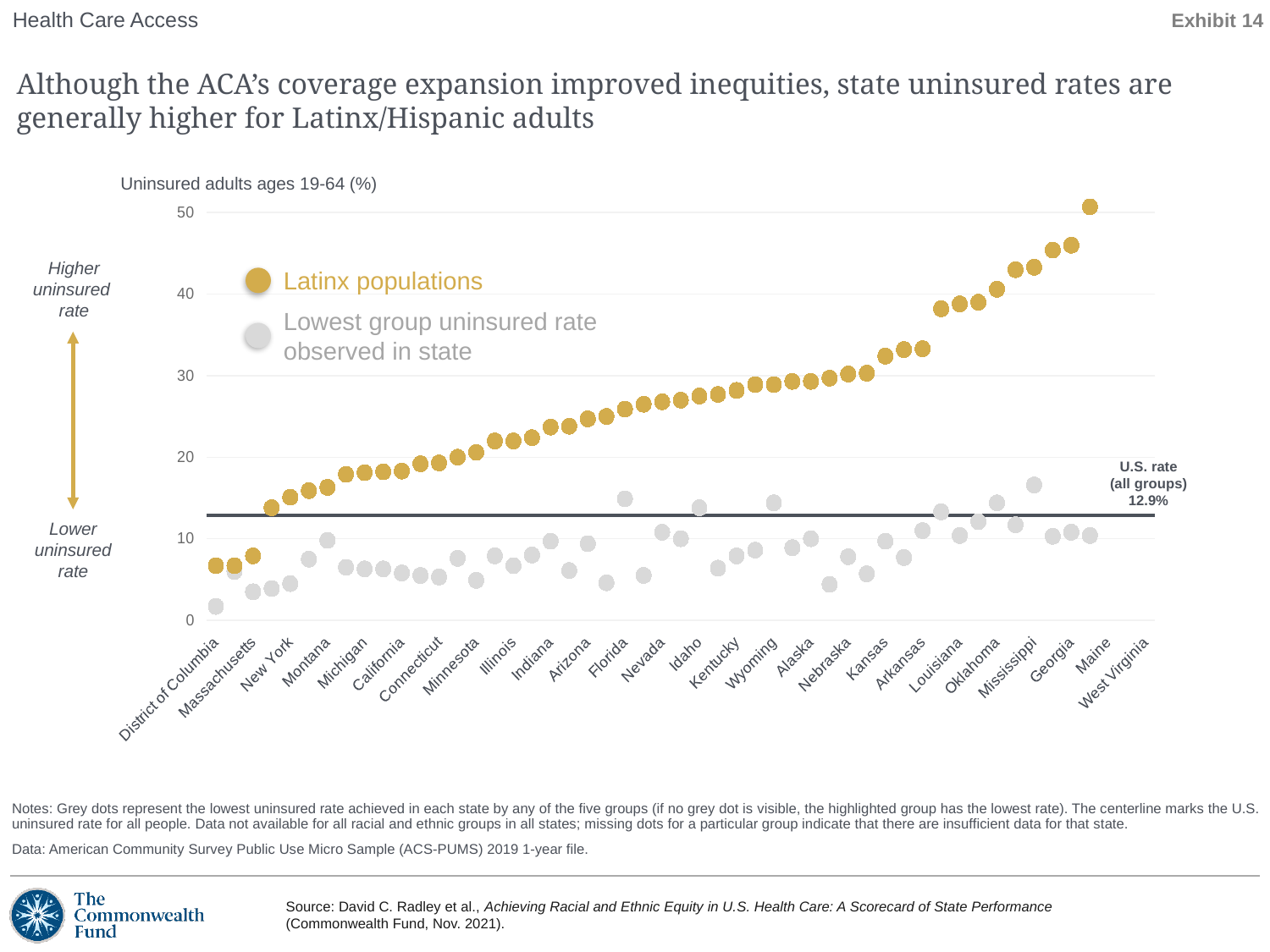
Is the Latinx population uninsured rate for District of Columbia greater or less than 10? less How many series does the legend list? 2 Is the Latinx population uninsured rate for Florida greater or less than 20? greater What kind of chart is shown on the slide? dot plot (scatter chart) Is the Latinx population uninsured rate for Louisiana greater or less than 30? greater Do the Latinx population uninsured rates rise or fall from left to right along the x axis? rise What colour are the dots for Latinx populations? gold What is the U.S. uninsured rate for all groups marked by the centerline? 12.9% What is the label on the vertical axis of the chart? Uninsured adults ages 19-64 (%)